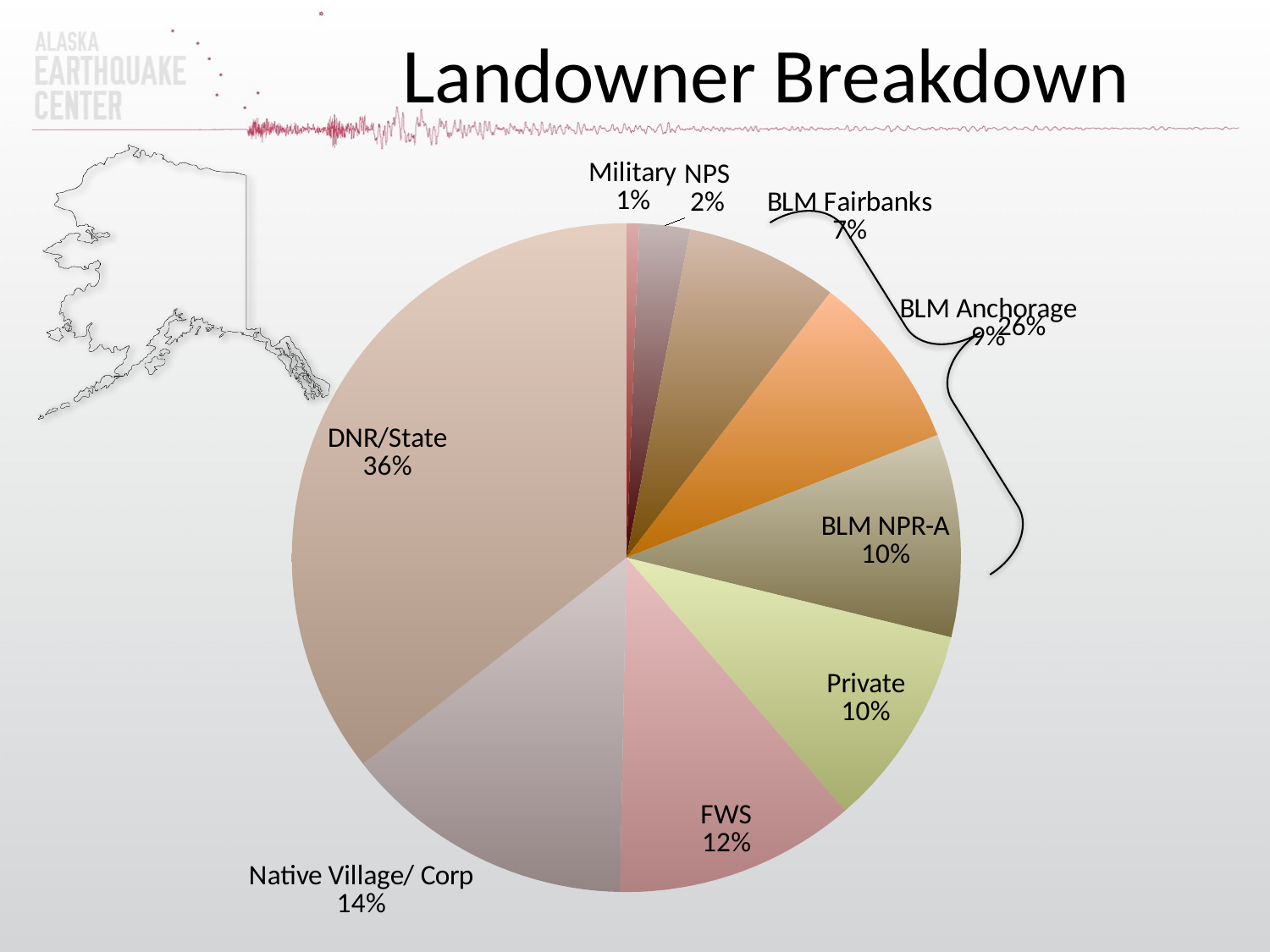
What percentage is shown for BLM Fairbanks? 7% Which landowner category has the smallest slice of the pie? Military What share of the pie does DNR/State hold? 36% What percentage is shown for FWS? 12% What is the title of the chart? Landowner Breakdown How many slices does the pie chart have? 9 What is the difference in percentage points between DNR/State and Native Village/ Corp? 22 Which landowner category has the largest slice of the pie? DNR/State Which is larger, the FWS slice or the BLM Anchorage slice? FWS What percentage is shown for NPS? 2% What percentage is shown for Native Village/ Corp? 14% What kind of chart is shown on the slide? pie chart